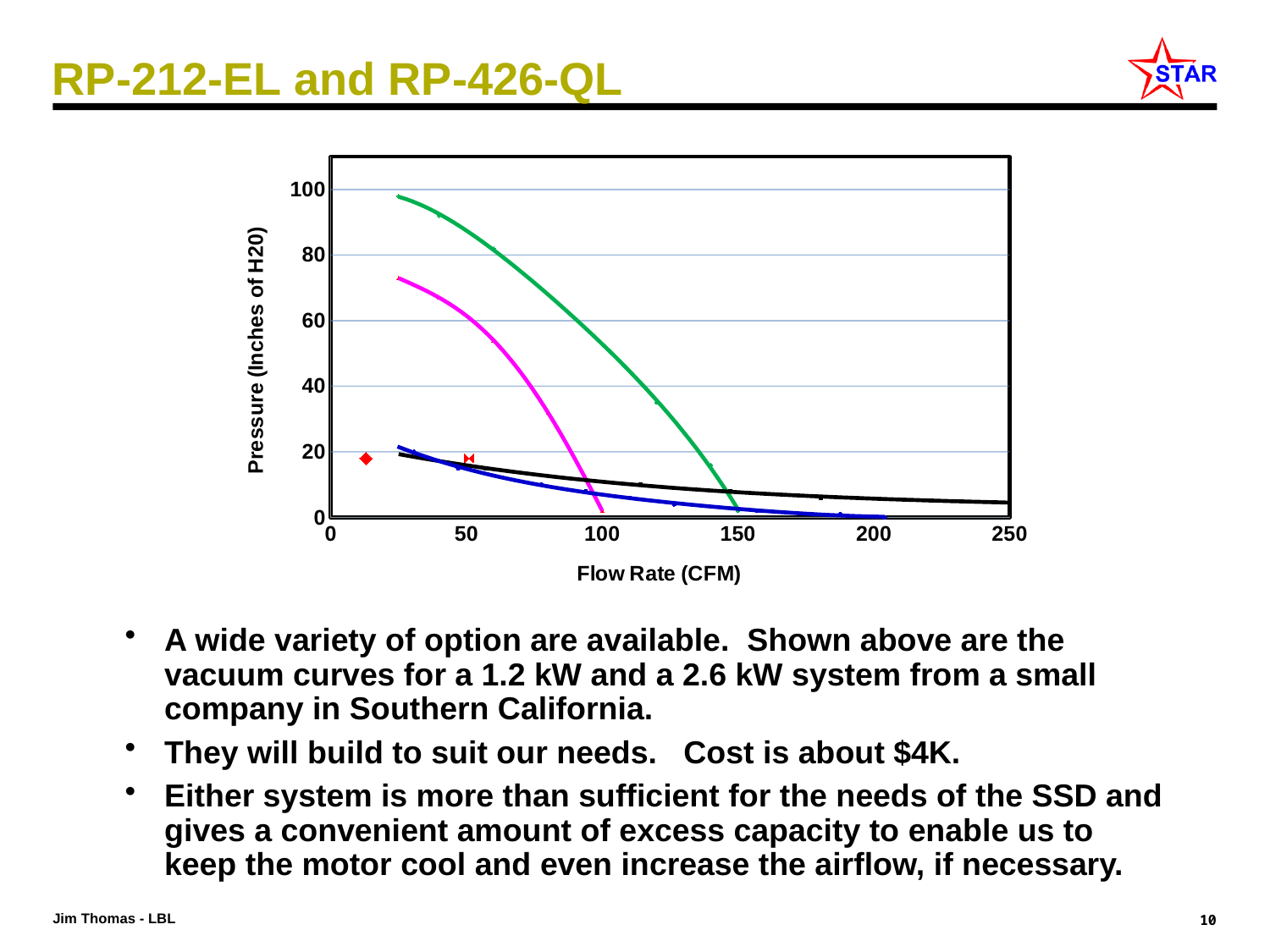
At a flow rate of 50 CFM, which curve shows the higher pressure, the green curve or the magenta curve? green curve Do the pressure curves rise or fall as the flow rate increases? fall Is the pressure of the blue curve at a flow rate of 100 CFM greater or less than 20? less Which curve reaches the highest pressure on the chart? green curve Is the pressure of the magenta curve at a flow rate of 100 CFM greater or less than 20? less What is the title of the x axis of the chart? Flow Rate (CFM) What is the title of the y axis of the chart? Pressure (Inches of H20) Is the pressure of the green curve at a flow rate of 50 CFM greater or less than 80? greater What kind of chart is shown on the slide? line chart